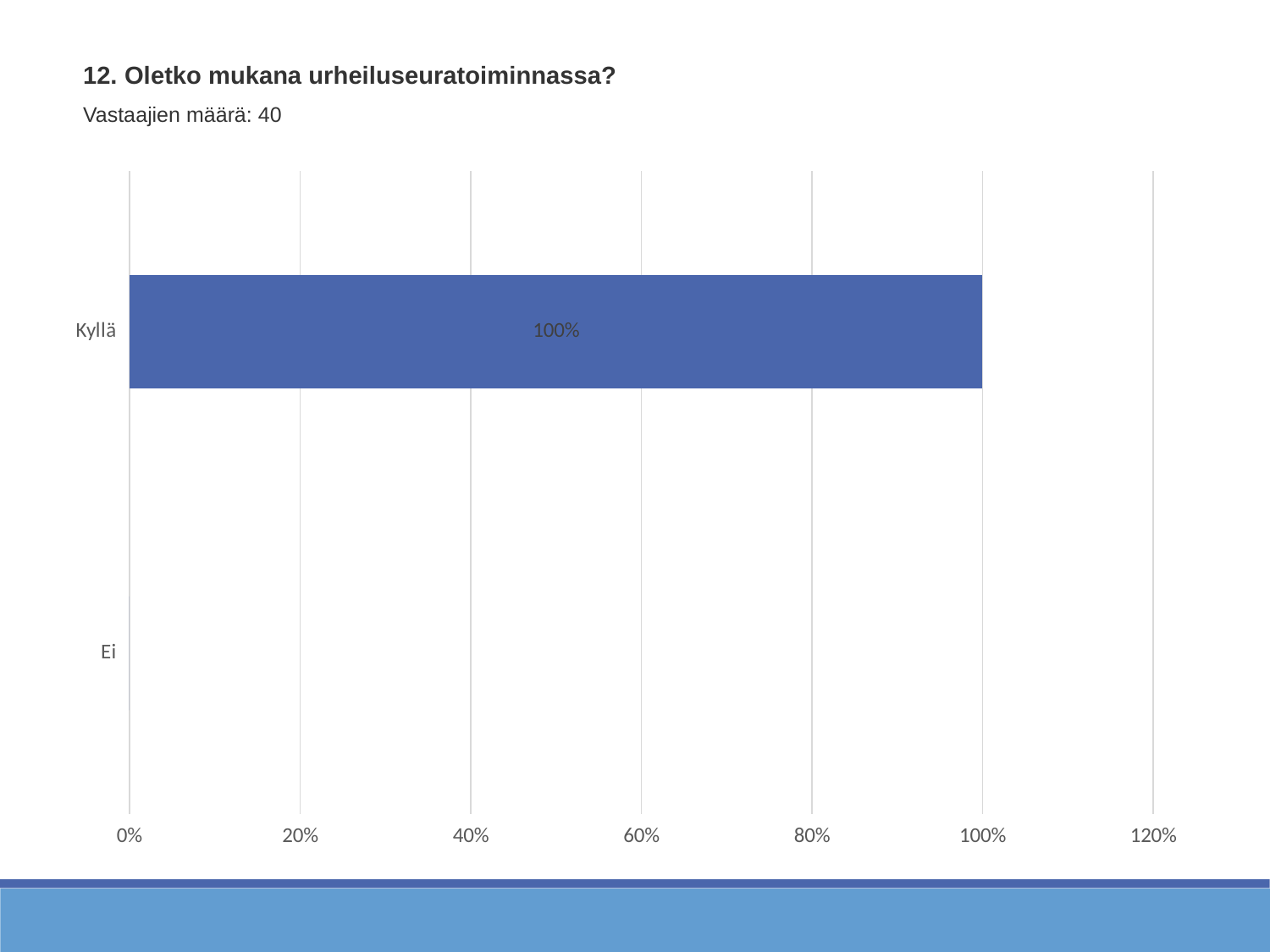
Is the value for Kyllä greater or less than 80%? greater What is the highest value shown on the x axis? 120% What is the value for Kyllä? 100% How many categories are shown on the chart? 2 What kind of chart is shown on the slide? bar chart Which category has the lowest value? Ei Which category has the highest value? Kyllä How many respondents does the slide report (Vastaajien määrä)? 40 Is the value for Ei greater or less than 20%? less Which is larger, the value for Kyllä or the value for Ei? Kyllä What is the title of the chart? 12. Oletko mukana urheiluseuratoiminnassa?